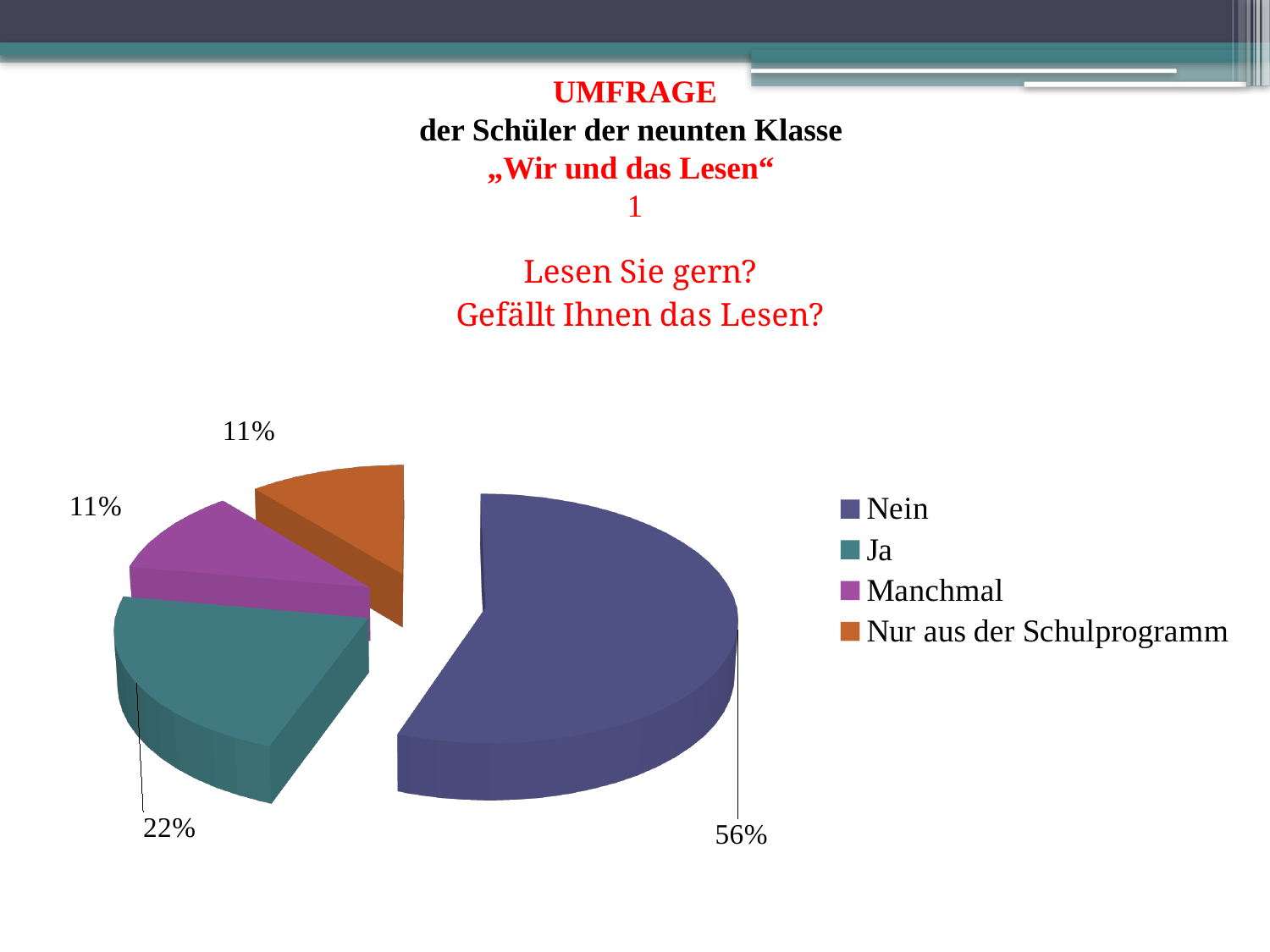
What percentage of students answered "Nein"? 56% What is the difference in percentage points between "Nein" and "Ja"? 34 How many categories does the pie chart show? 4 Which is larger, the share for "Nein" or the share for "Ja"? Nein What kind of chart is shown on the slide? Pie chart What is the difference in percentage points between "Ja" and "Manchmal"? 11 What percentage of students answered "Manchmal"? 11% Which category is shown in orange in the legend? Nur aus der Schulprogramm What percentage of students answered "Ja"? 22% What percentage of students answered "Nur aus der Schulprogramm"? 11% Which answer has the largest share of the pie? Nein Which is larger, the share for "Ja" or the share for "Manchmal"? Ja